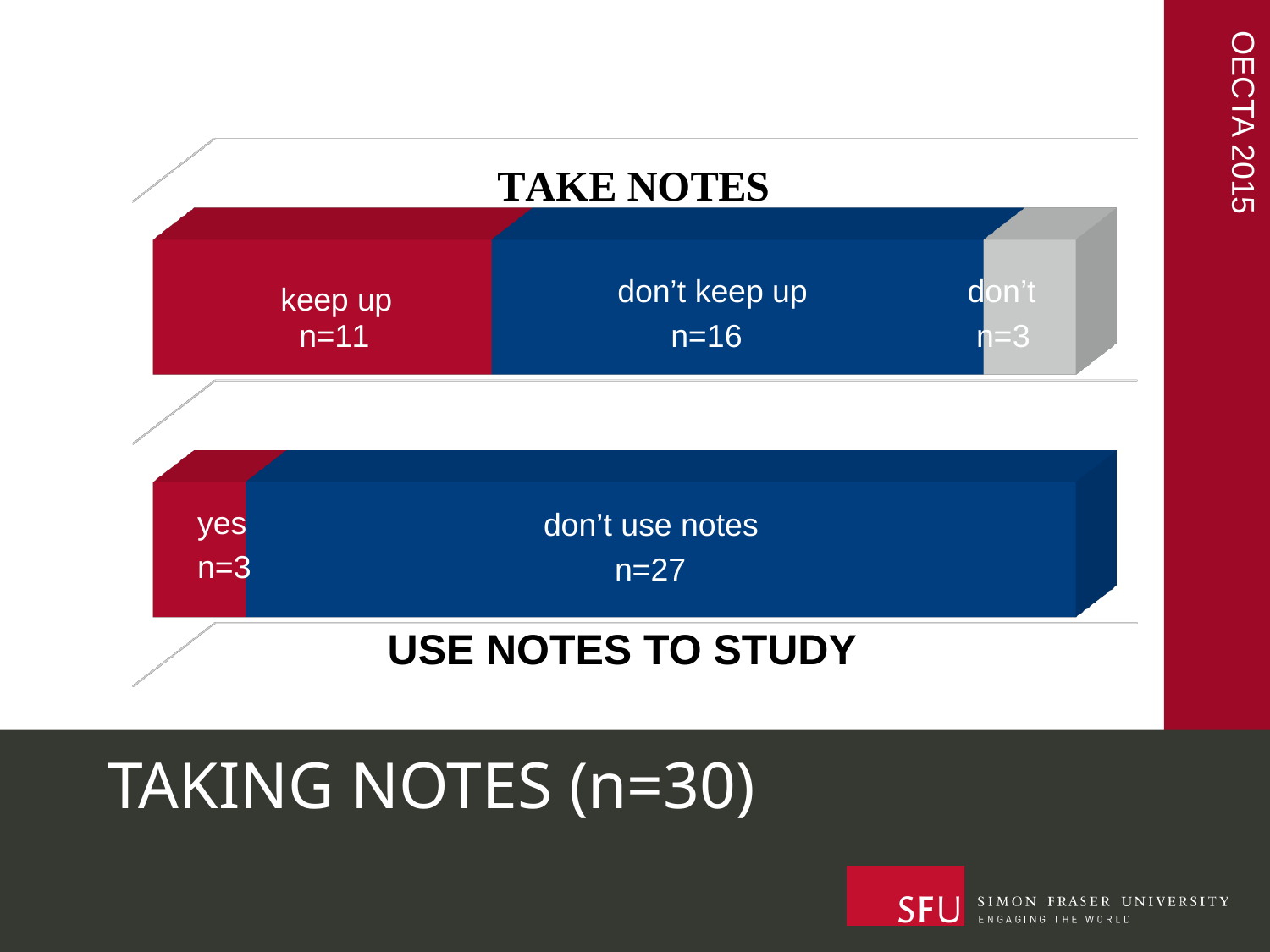
In the TAKE NOTES chart, what is the value for the 'don't' segment? n=3 In the TAKE NOTES chart, what is the difference between 'don't keep up' and 'keep up'? 5 What is the total of the segments in the USE NOTES TO STUDY bar? 30 In the TAKE NOTES chart, how many segments make up the bar? 3 In the USE NOTES TO STUDY chart, what is the value for 'yes'? n=3 In the TAKE NOTES chart, what is the value for the 'don't keep up' segment? n=16 In the TAKE NOTES chart, which segment has the largest value? don't keep up What kind of chart is used on this slide? Stacked bar chart In the USE NOTES TO STUDY chart, what is the value for 'don't use notes'? n=27 In the TAKE NOTES chart, which segment has the smallest value? don't In the TAKE NOTES chart, what is the value for the 'keep up' segment? n=11 In the USE NOTES TO STUDY chart, what is the difference between 'don't use notes' and 'yes'? 24